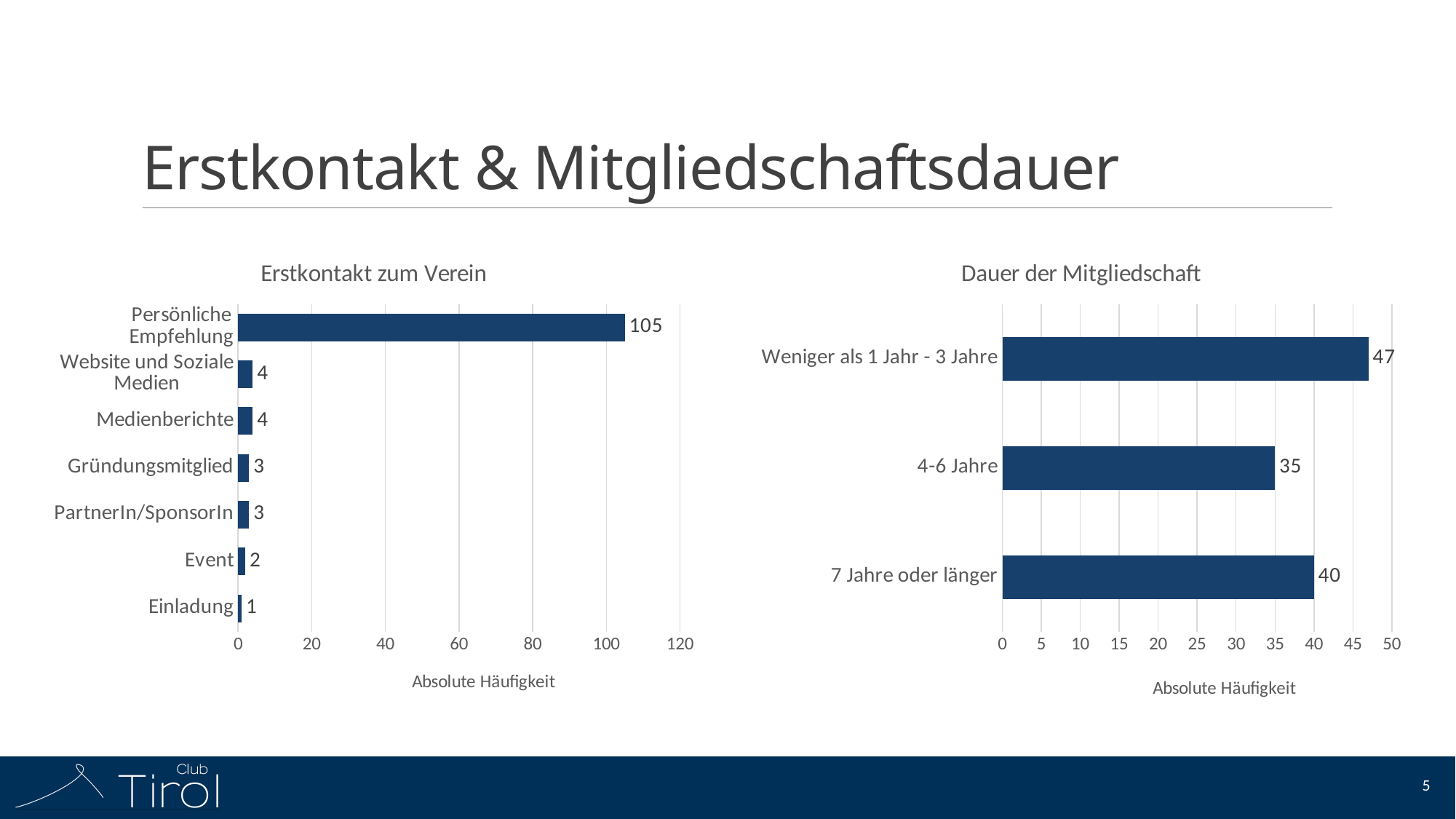
In the 'Dauer der Mitgliedschaft' chart, what is the difference between Weniger als 1 Jahr - 3 Jahre and 7 Jahre oder länger? 7 In the 'Dauer der Mitgliedschaft' chart, which category has the highest value? Weniger als 1 Jahr - 3 Jahre In the 'Erstkontakt zum Verein' chart, which category has the highest value? Persönliche Empfehlung In the 'Dauer der Mitgliedschaft' chart, which is larger: 7 Jahre oder länger or 4-6 Jahre? 7 Jahre oder länger What kind of chart is the 'Dauer der Mitgliedschaft' chart? Bar chart In the 'Erstkontakt zum Verein' chart, what is the value for Gründungsmitglied? 3 In the 'Erstkontakt zum Verein' chart, how many categories are shown? 7 In the 'Erstkontakt zum Verein' chart, what is the difference between Persönliche Empfehlung and Medienberichte? 101 In the 'Erstkontakt zum Verein' chart, which category has the lowest value? Einladung In the 'Dauer der Mitgliedschaft' chart, what is the value for 4-6 Jahre? 35 What is the x-axis label of the 'Erstkontakt zum Verein' chart? Absolute Häufigkeit In the 'Erstkontakt zum Verein' chart, what is the value for Persönliche Empfehlung? 105